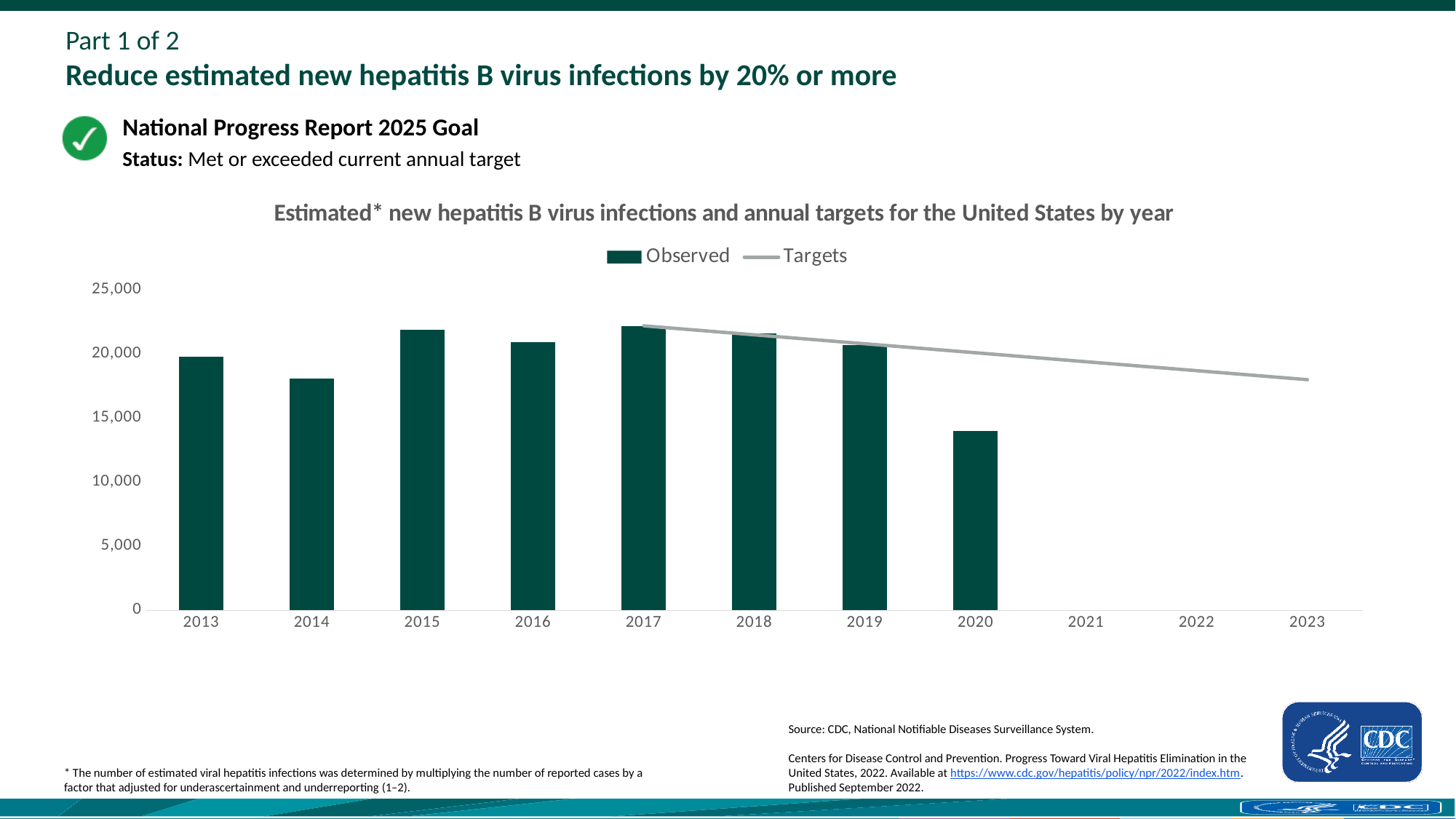
Is the Observed value for 2014 greater or less than 20,000? less What kind of chart is shown on the slide? combination bar and line chart Is the Observed value for 2017 greater or less than 20,000? greater Is the Observed value for 2020 greater or less than 15,000? less How many series does the chart legend list? 2 Does the Targets line rise or fall from 2017 to 2023? fall What are the two series named in the chart legend? Observed and Targets Which year has the larger Observed value, 2014 or 2015? 2015 How many years have an Observed bar plotted in the chart? 8 Which year has the larger Observed value, 2019 or 2020? 2019 Which year has the lowest Observed value? 2020